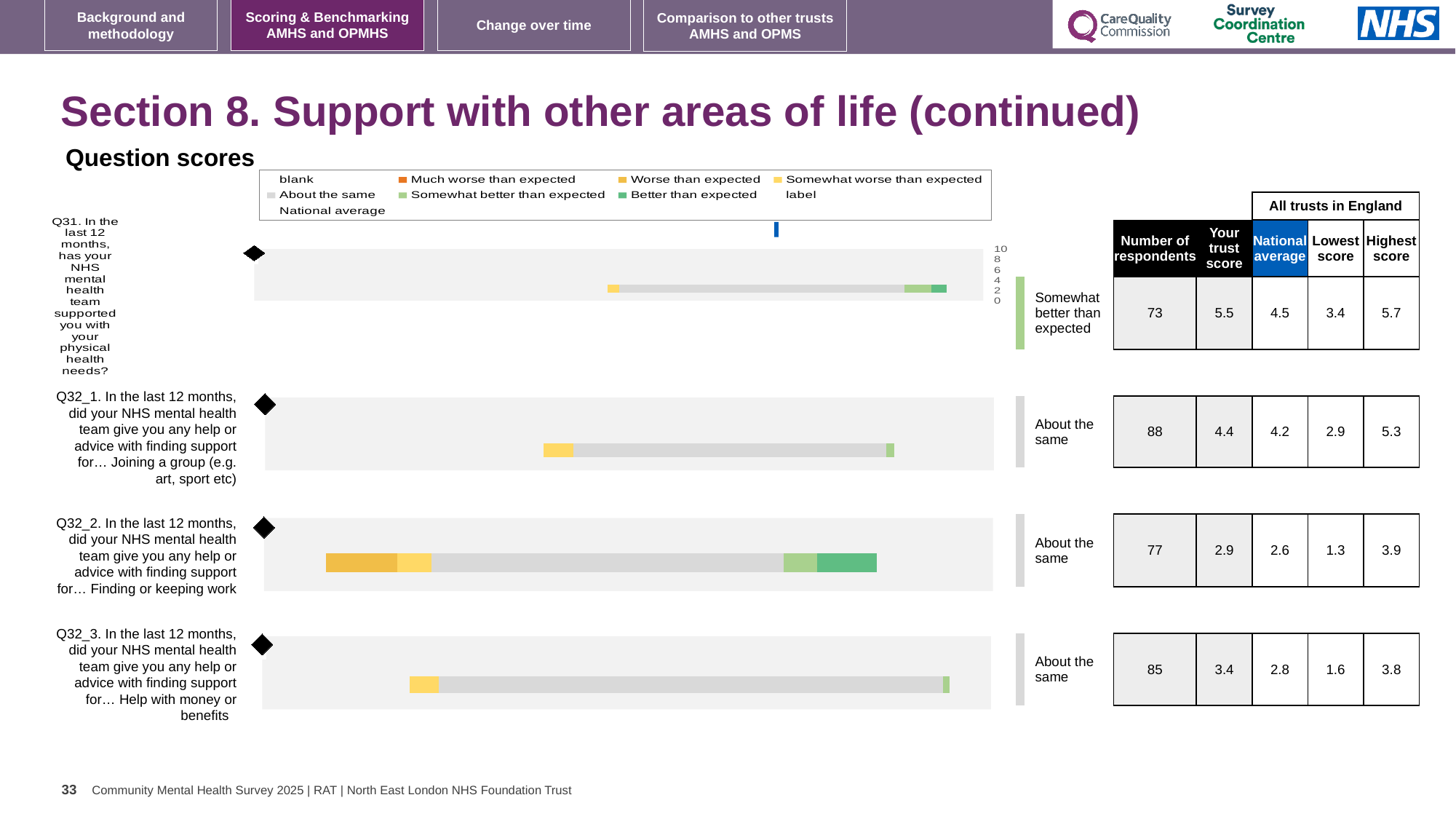
How many questions (bars) are shown in the question scores chart? 4 For Q32_1 (joining a group), which is larger: the trust score or the national average? the trust score What is the highest score among all trusts in England for Q32_2? 3.9 Which question has the highest trust score? Q31 What benchmark category is shown for Q31? Somewhat better than expected What is the trust score for Q31 (support with physical health needs)? 5.5 What is the difference between the highest and lowest scores among all trusts in England for Q31? 2.3 How many respondents answered Q32_3 (help with money or benefits)? 85 What is the difference between the trust score and the national average for Q32_3? 0.6 Which question has the lowest trust score? Q32_2 What is the national average for Q32_2 (finding or keeping work)? 2.6 What kind of chart is used to show the question scores on this slide? bar chart